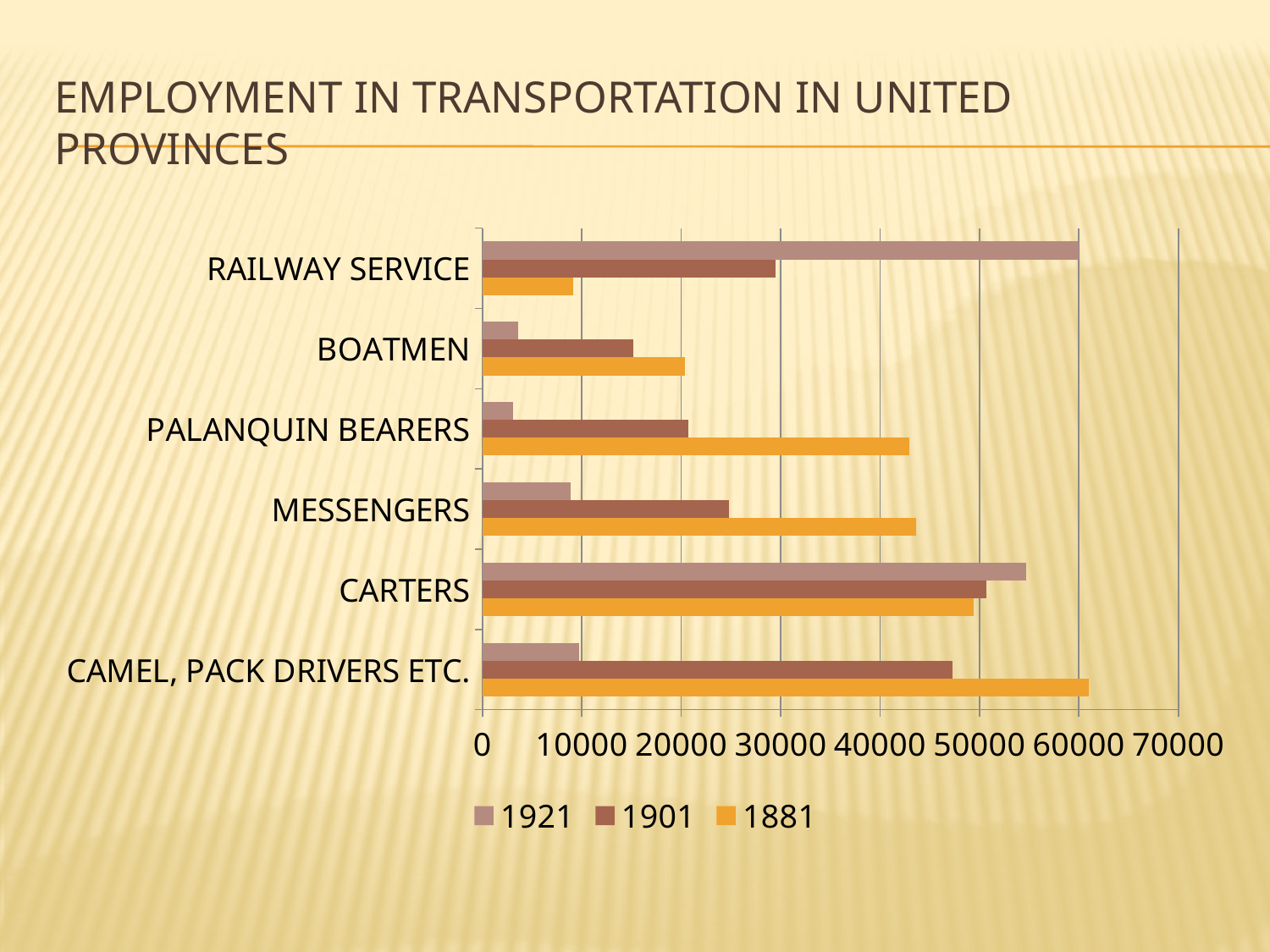
Which category has the highest 1921 value? Railway Service For Railway Service, which is larger: the 1921 value or the 1901 value? 1921 Is the 1881 value for Camel, Pack Drivers etc. greater or less than 60000? greater Which category has the lowest 1881 value? Railway Service How many series does the legend list? 3 How many occupation categories are shown on the chart? 6 Which year does the orange series in the legend represent? 1881 What kind of chart is shown on the slide? bar chart Is the 1921 value for Railway Service greater or less than 50000? greater For Palanquin Bearers, which is larger: the 1881 value or the 1901 value? 1881 Is the 1881 value for Railway Service greater or less than 10000? less